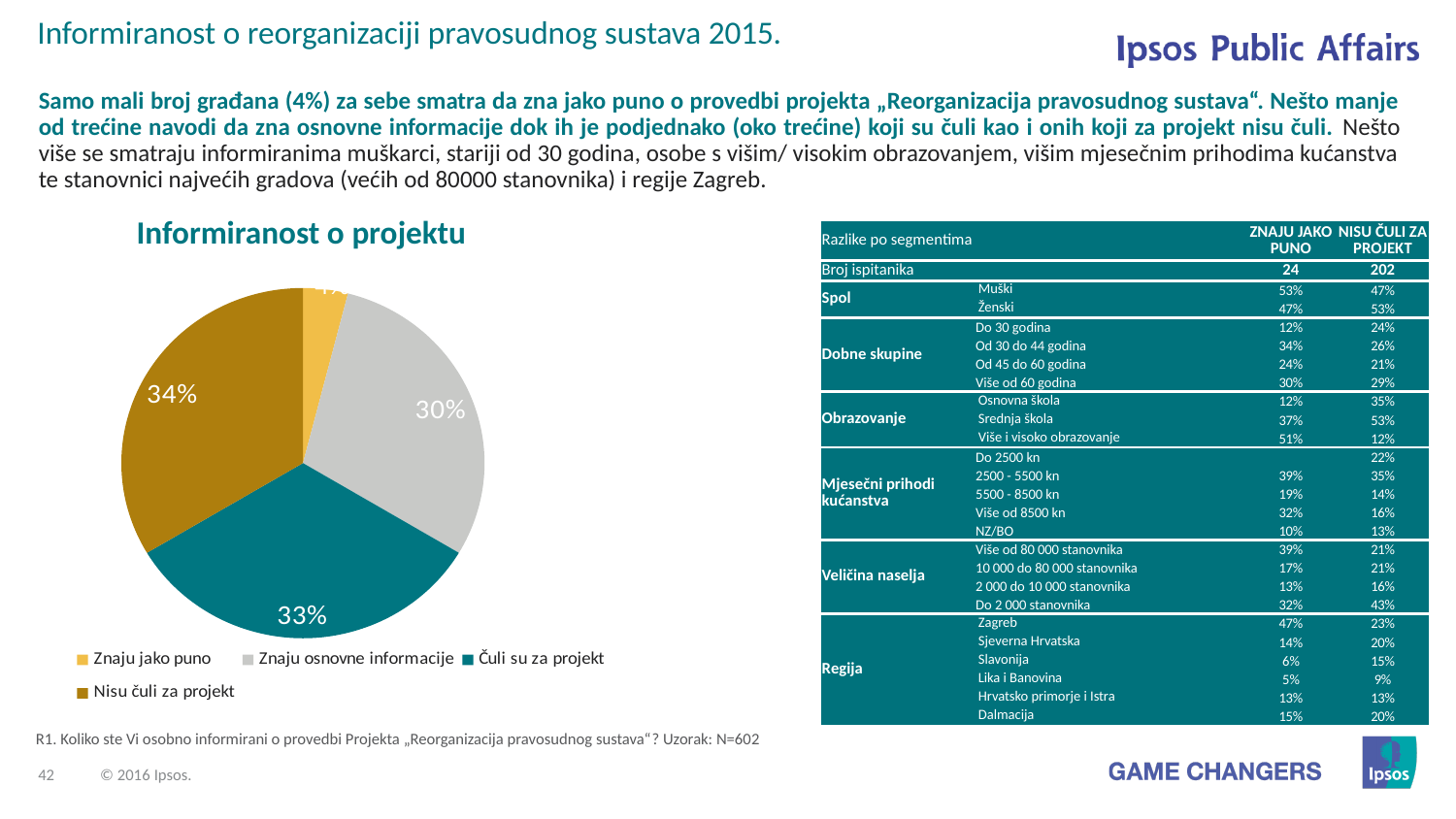
What is the difference between the 'Nisu čuli za projekt' and 'Znaju osnovne informacije' slices? 4 percentage points What percentage of the pie is 'Znaju osnovne informacije'? 30% What percentage of the pie is 'Nisu čuli za projekt'? 34% Which category has the smallest slice of the pie? Znaju jako puno What kind of chart is shown on the slide? pie chart What percentage of the pie is 'Čuli su za projekt'? 33% What is the title of the chart? Informiranost o projektu Which category has the largest slice of the pie? Nisu čuli za projekt Which category is shown in the teal slice of the pie? Čuli su za projekt What is the combined share of 'Čuli su za projekt' and 'Nisu čuli za projekt'? 67% How many categories does the pie chart have? 4 Which is larger: 'Čuli su za projekt' or 'Znaju osnovne informacije'? Čuli su za projekt